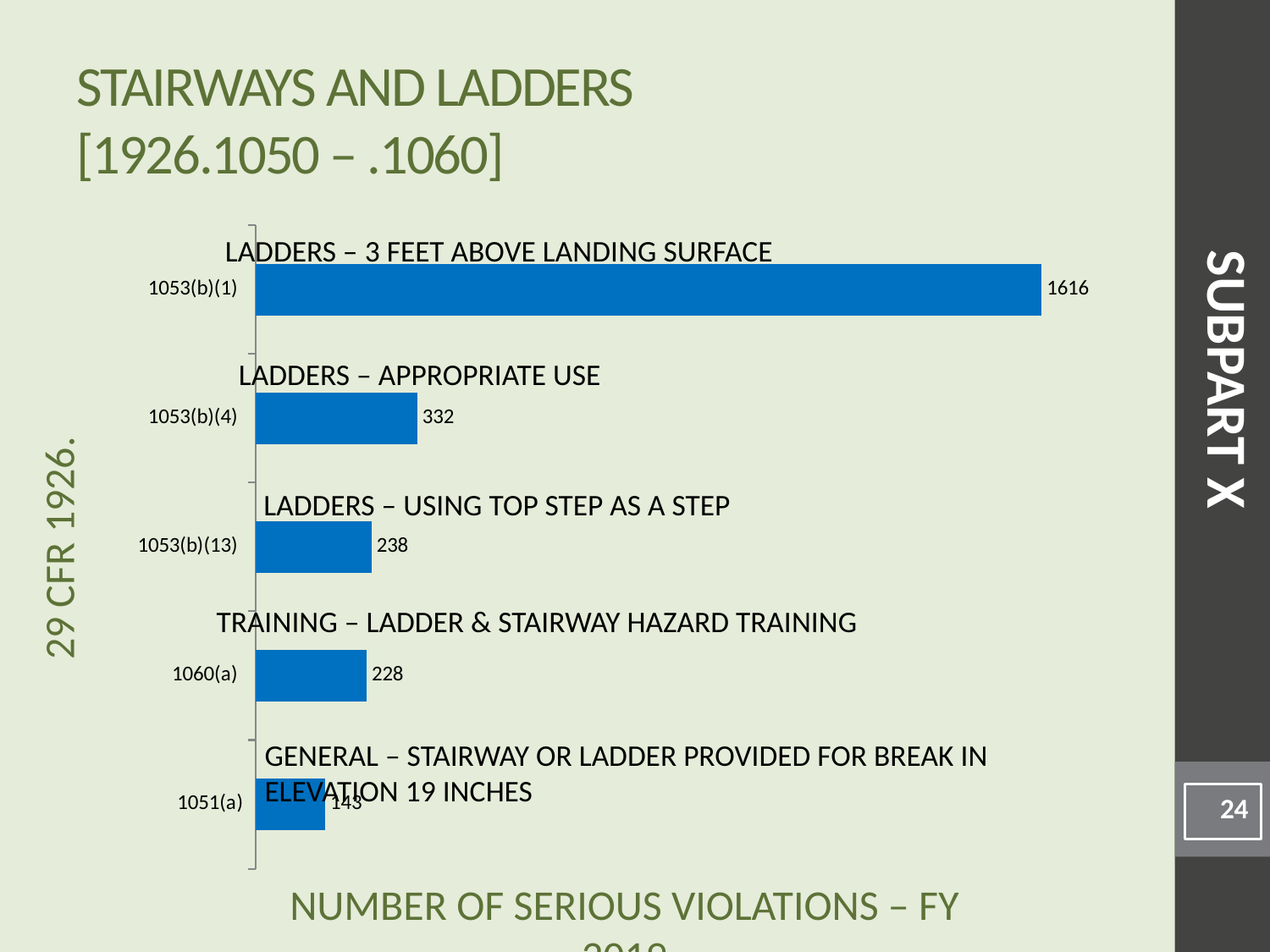
What is the number of serious violations for 1053(b)(13)? 238 What is the number of serious violations for 1060(a)? 228 How many standards (bars) are shown in the chart? 5 What is the difference between the violations for 1053(b)(1) and 1053(b)(4)? 1284 Which has more serious violations, 1053(b)(4) or 1060(a)? 1053(b)(4) What type of chart is shown on the slide? Bar chart What is the number of serious violations for 1053(b)(1)? 1616 Which standard has the highest number of serious violations? 1053(b)(1) What description is written above the bar for 1053(b)(1)? LADDERS – 3 FEET ABOVE LANDING SURFACE Which standard has the lowest number of serious violations? 1051(a) What is the number of serious violations for 1053(b)(4)? 332 What is the difference between the violations for 1053(b)(13) and 1060(a)? 10